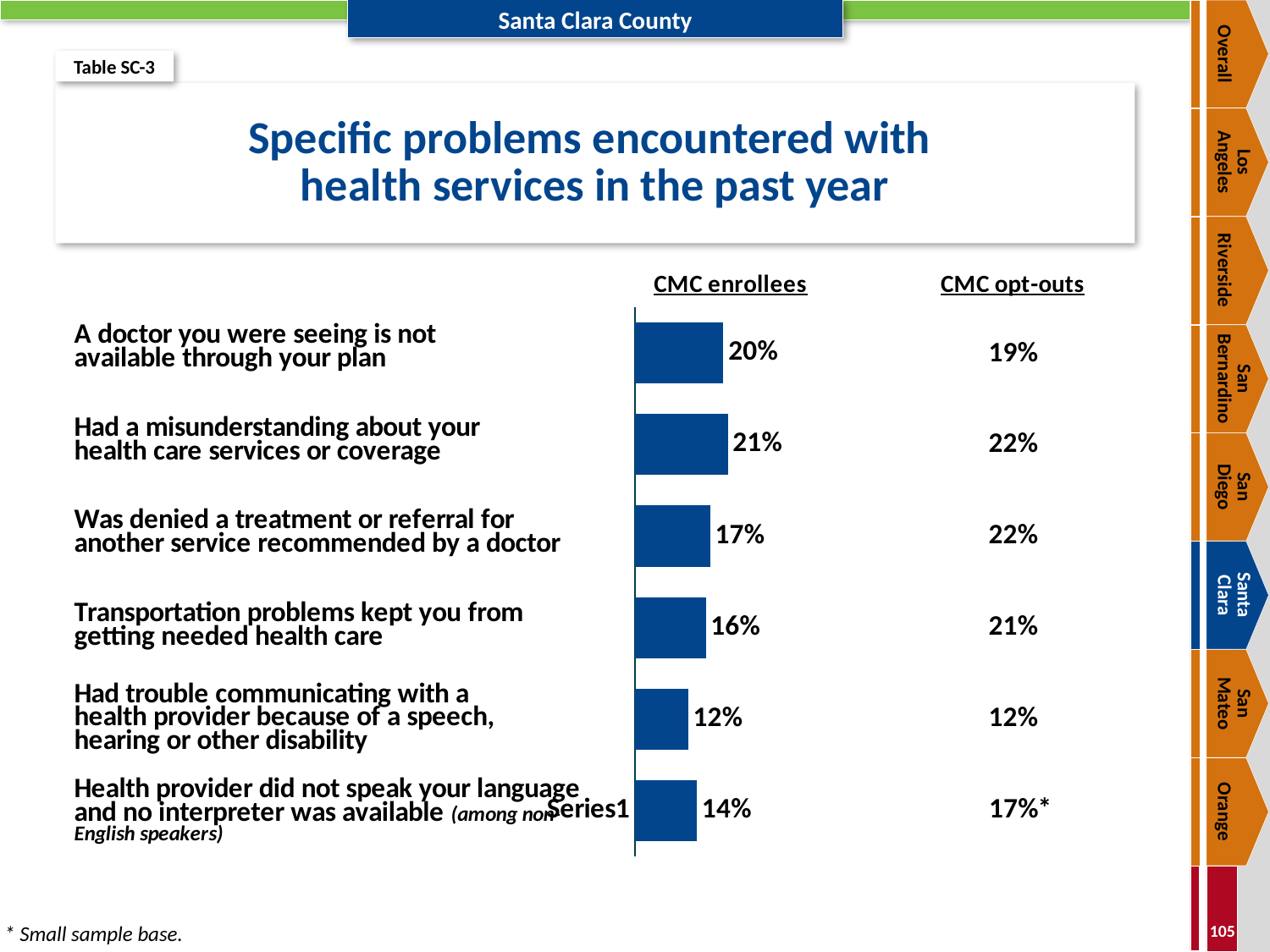
What is the CMC enrollees value for "Health provider did not speak your language and no interpreter was available"? 14% Which problem has the highest CMC enrollees value in the bar chart? Had a misunderstanding about your health care services or coverage What is the difference in percentage points between the CMC enrollees values for "A doctor you were seeing is not available through your plan" and "Transportation problems kept you from getting needed health care"? 4 percentage points What is the CMC enrollees value for "Transportation problems kept you from getting needed health care"? 16% What is the title of the chart on the slide? Specific problems encountered with health services in the past year Which group's values are plotted as bars in the chart? CMC enrollees Among CMC enrollees, which is larger: "Was denied a treatment or referral for another service recommended by a doctor" or "Health provider did not speak your language and no interpreter was available"? Was denied a treatment or referral for another service recommended by a doctor Which problem has the lowest CMC enrollees value in the bar chart? Had trouble communicating with a health provider because of a speech, hearing or other disability What is the CMC enrollees value for "A doctor you were seeing is not available through your plan"? 20% What is the CMC enrollees value for "Had a misunderstanding about your health care services or coverage"? 21% How many problem categories are plotted as bars in the chart? 6 What kind of chart is shown on the slide? Bar chart